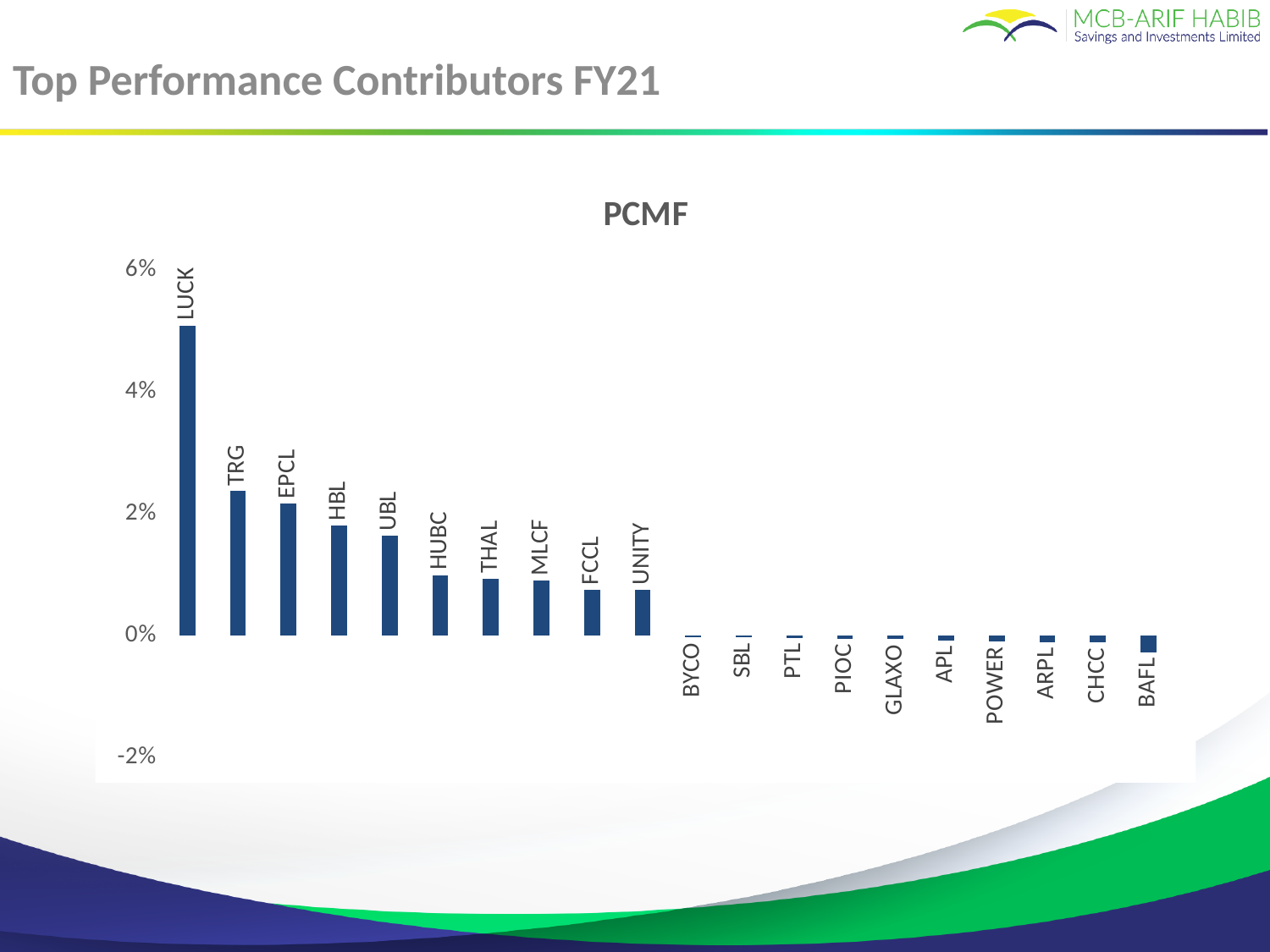
What is the title of the chart? PCMF Is the value for HBL greater or less than 2%? less Which category has the lowest value? BAFL Is the value for HUBC greater or less than 2%? less Is the value for TRG greater or less than 2%? greater Which is larger, the value for LUCK or the value for TRG? LUCK Which category has the highest value? LUCK Which is larger, the value for HBL or the value for HUBC? HBL What kind of chart is shown on the slide? bar chart How many categories are plotted in the chart? 20 Do the values rise or fall moving from left to right along the x axis? fall